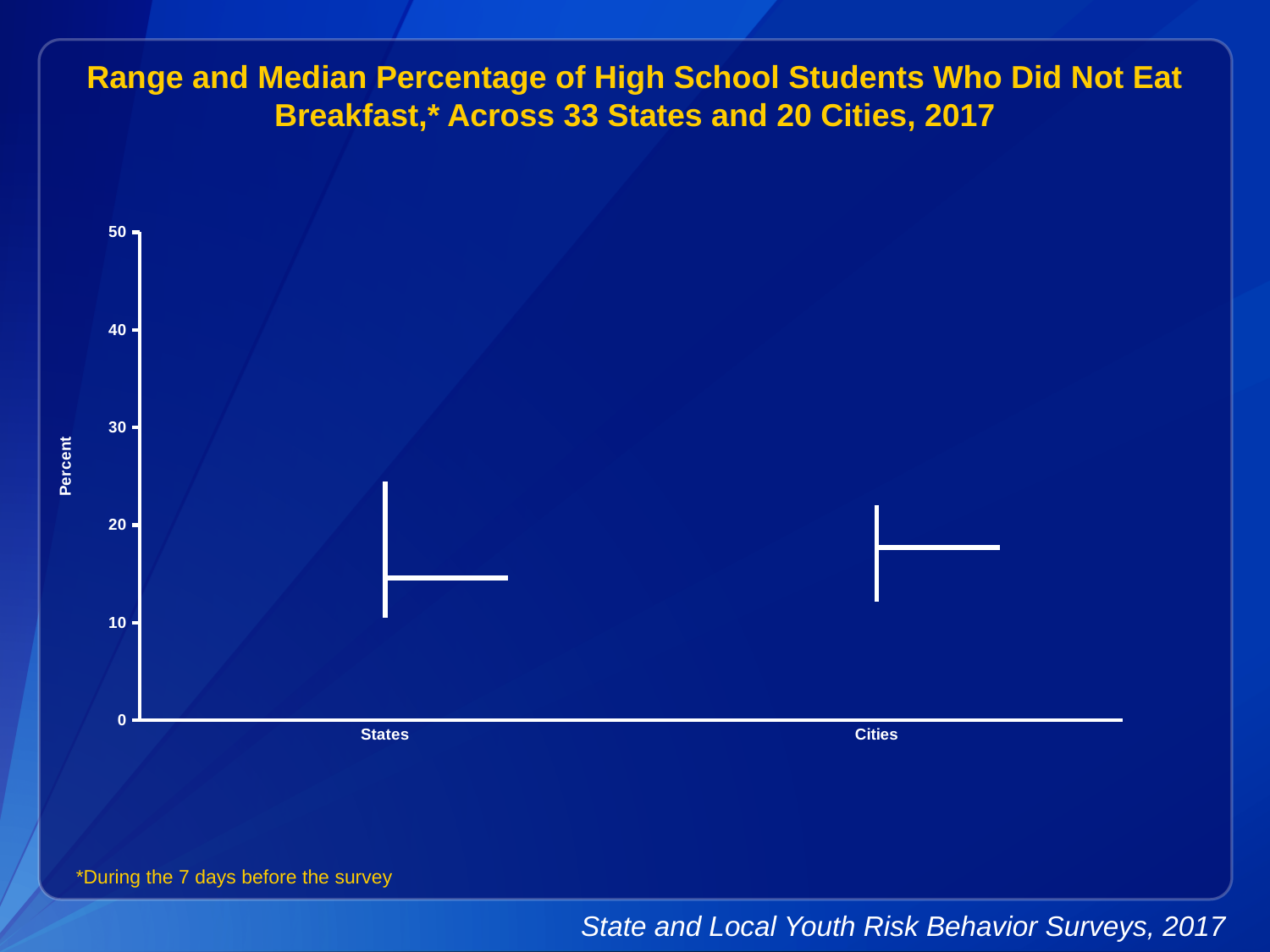
Which category has the higher median value, States or Cities? Cities Is the median value for States greater or less than 20? less Which category has the higher top of its range, States or Cities? States Is the top of the range for States greater or less than 20? greater Is the top of the range for Cities greater or less than 20? greater What are the two categories shown on the x axis? States and Cities How many categories are shown on the x axis of the chart? 2 What is the label on the y axis of the chart? Percent What is the highest value shown on the y axis? 50